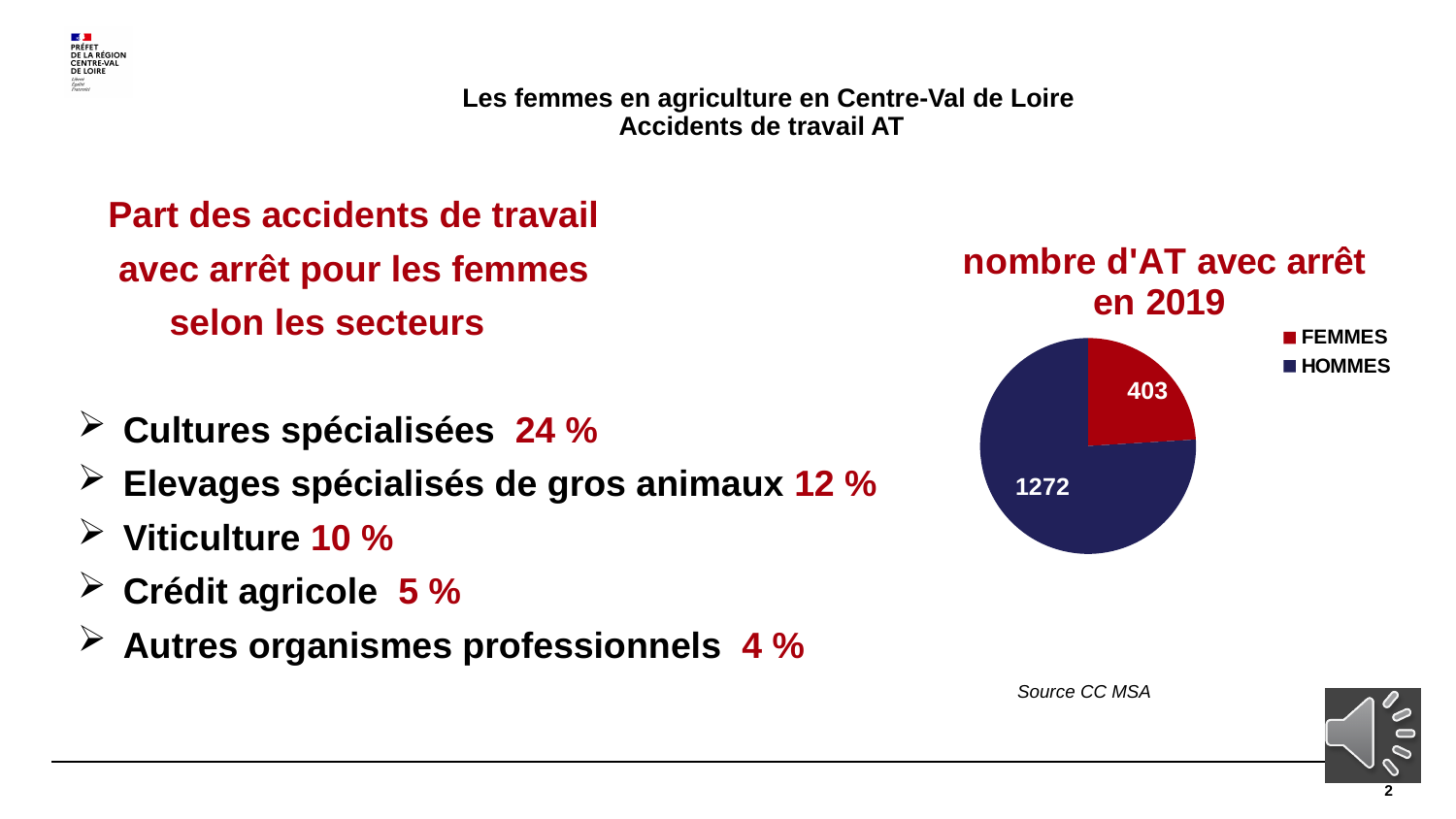
What is the value for HOMMES in the pie chart? 1272 Which colour represents FEMMES in the pie chart? red What is the total of the two values shown in the pie chart? 1675 How many slices does the pie chart have? 2 Which is larger in the pie chart, FEMMES or HOMMES? HOMMES What type of chart is shown on the slide? pie chart What is the value for FEMMES in the pie chart? 403 Which category has the largest slice in the pie chart? HOMMES How many entries does the legend of the pie chart list? 2 Which category has the smallest slice in the pie chart? FEMMES What is the difference between the HOMMES and FEMMES values in the pie chart? 869 What is the title of the pie chart? nombre d'AT avec arrêt en 2019